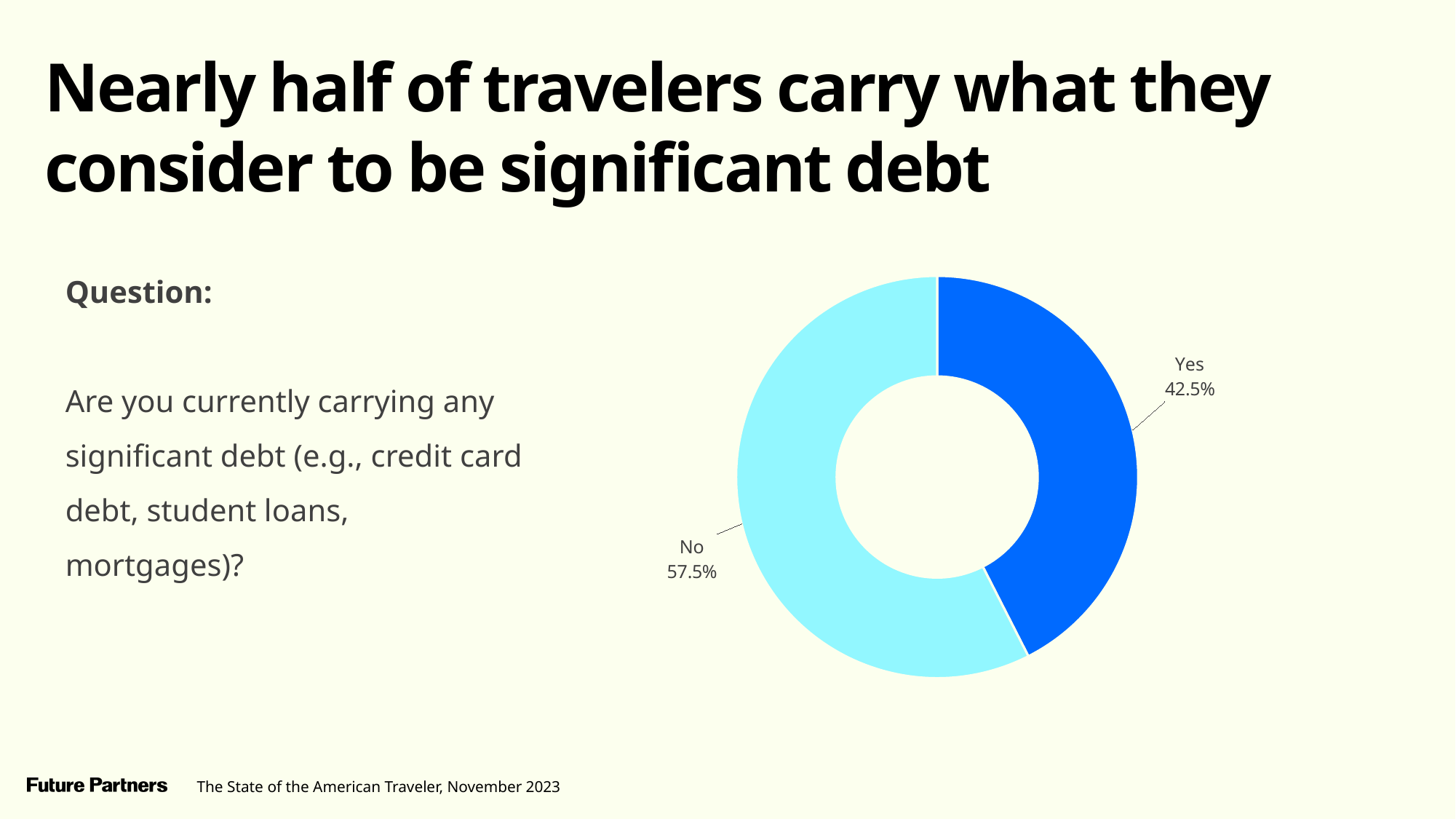
What percentage of travelers answered "Yes" to currently carrying significant debt? 42.5% Which slice of the chart is shown in dark blue? Yes Is the value for No greater or less than 50%? greater How many response categories are shown in the chart? 2 What share of the chart does the Yes slice represent? 42.5% What kind of chart is shown on the slide? Pie chart (donut) What is the difference in percentage points between the No and Yes shares? 15 percentage points Is the share for Yes larger or smaller than the share for No? smaller Which response has the larger share of the chart, Yes or No? No What survey question does the chart report responses to? Are you currently carrying any significant debt (e.g., credit card debt, student loans, mortgages)? Which response has the smaller share of the chart? Yes What percentage of travelers answered "No" to currently carrying significant debt? 57.5%